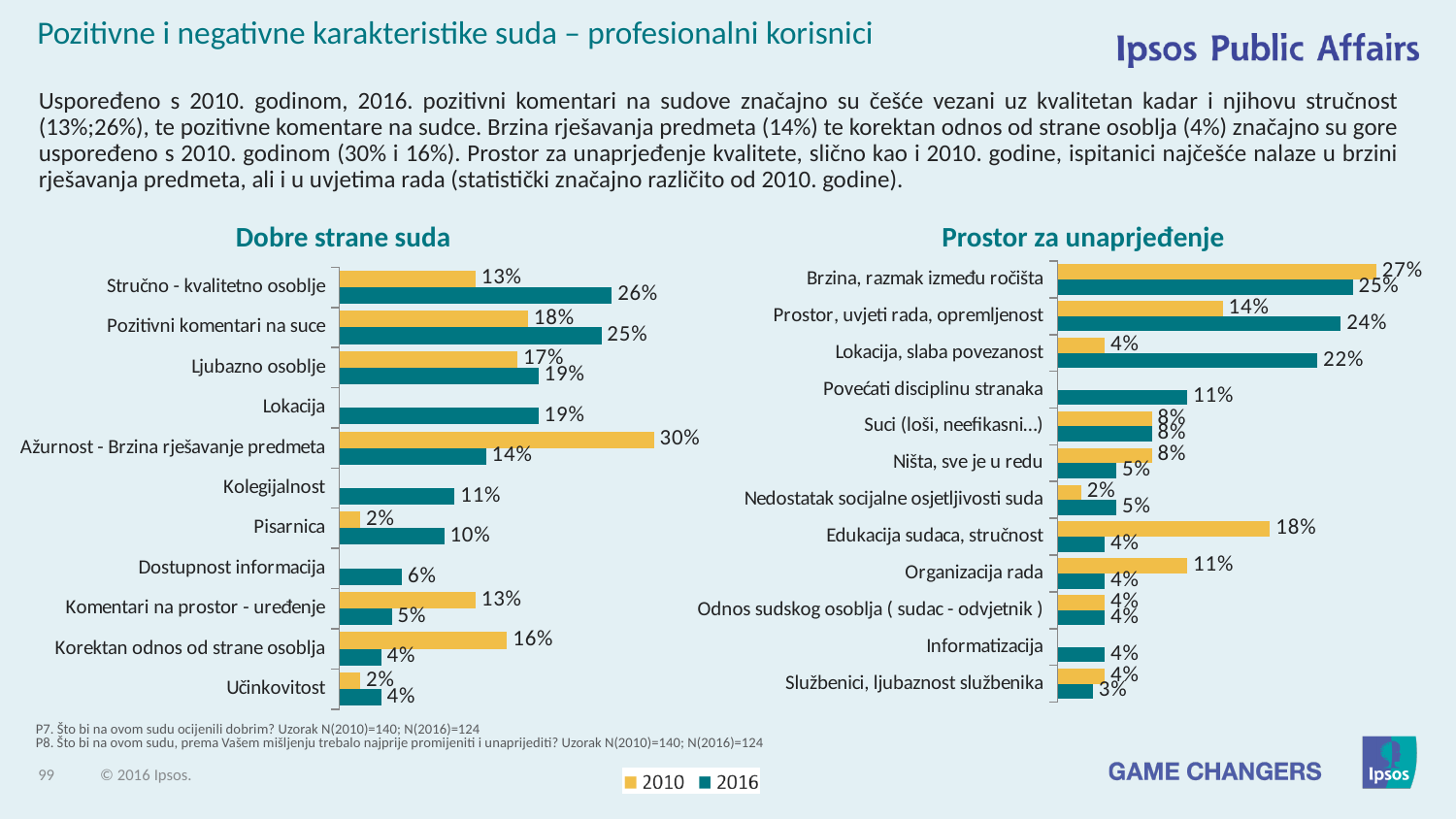
In the 'Prostor za unaprjeđenje' chart, what is the 2010 value for 'Edukacija sudaca, stručnost'? 18% How many series does the legend list? 2 In the 'Prostor za unaprjeđenje' chart, which category has the highest 2010 value? Brzina, razmak između ročišta In the 'Dobre strane suda' chart, what is the 2010 value for 'Ažurnost - Brzina rješavanje predmeta'? 30% In the 'Prostor za unaprjeđenje' chart, which is larger for 'Prostor, uvjeti rada, opremljenost': the 2010 value or the 2016 value? 2016 In the 'Dobre strane suda' chart, how many categories are listed? 11 In the 'Prostor za unaprjeđenje' chart, what is the 2016 value for 'Lokacija, slaba povezanost'? 22% In the 'Dobre strane suda' chart, what is the 2016 value for 'Stručno - kvalitetno osoblje'? 26% What type of chart is 'Dobre strane suda'? Bar chart In the 'Dobre strane suda' chart, which category has the highest 2016 value? Stručno - kvalitetno osoblje In the 'Prostor za unaprjeđenje' chart, what is the difference between the 2010 and 2016 values for 'Organizacija rada'? 7% In the 'Dobre strane suda' chart, what is the difference between the 2010 and 2016 values for 'Korektan odnos od strane osoblja'? 12%